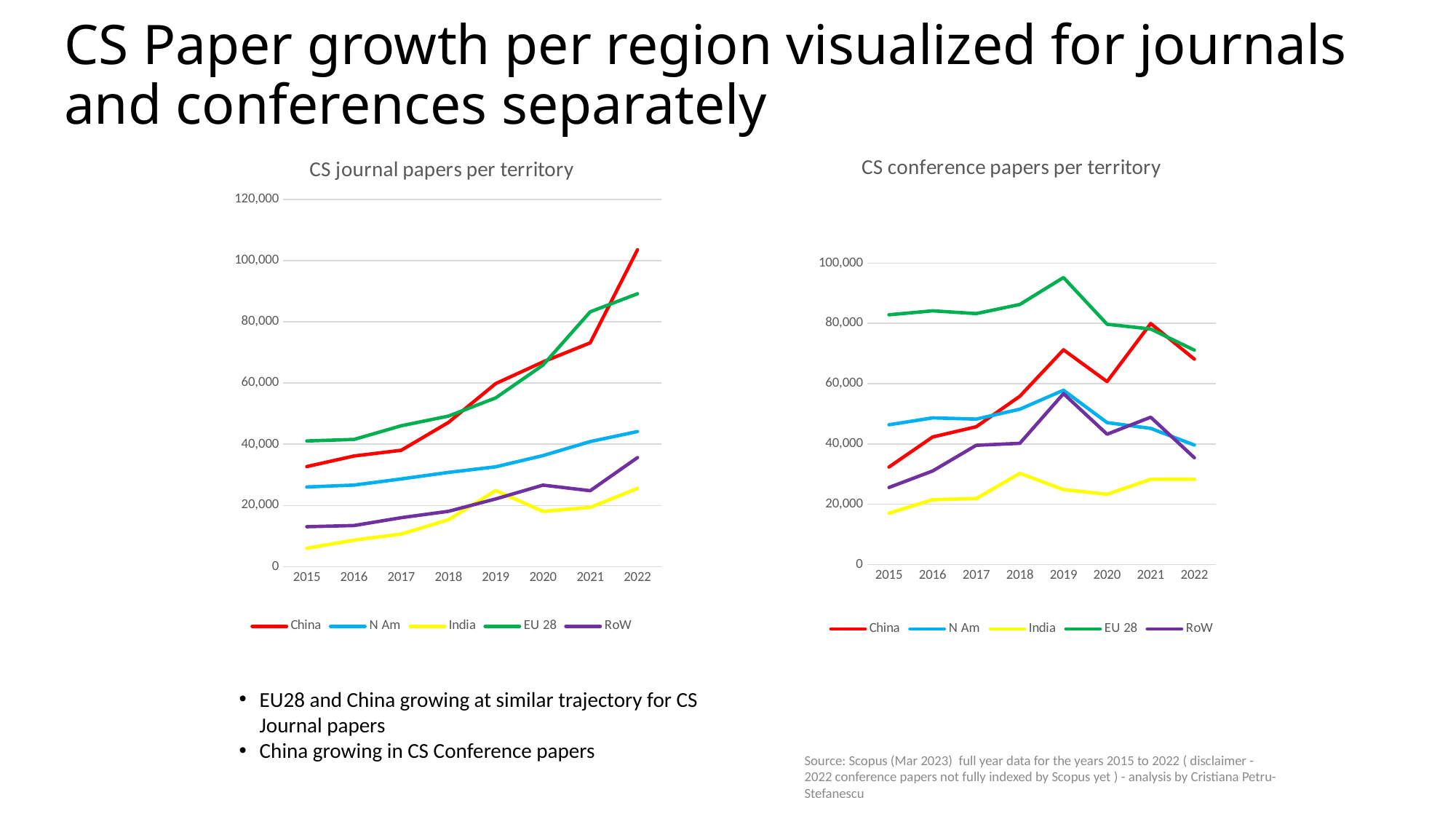
In the 'CS journal papers per territory' chart, does the China line rise or fall from 2015 to 2022? rise In the 'CS conference papers per territory' chart, which territory has the highest value in 2019? EU 28 In the 'CS journal papers per territory' chart, is the value for India in 2015 greater or less than 20,000? less In the 'CS conference papers per territory' chart, which is larger in 2015: EU 28 or China? EU 28 In the 'CS conference papers per territory' chart, which territory has the lowest value in 2022? India What kind of chart is the 'CS journal papers per territory' chart? line chart In the 'CS journal papers per territory' chart, is the value for China in 2022 greater or less than 100,000? greater How many years are shown on the x axis of the 'CS journal papers per territory' chart? 8 In the 'CS conference papers per territory' chart, is the value for China in 2019 greater or less than 60,000? greater In the 'CS journal papers per territory' chart, which territory has the lowest value in 2015? India How many series does the legend of the 'CS conference papers per territory' chart list? 5 In the 'CS journal papers per territory' chart, which territory has the highest value in 2022? China